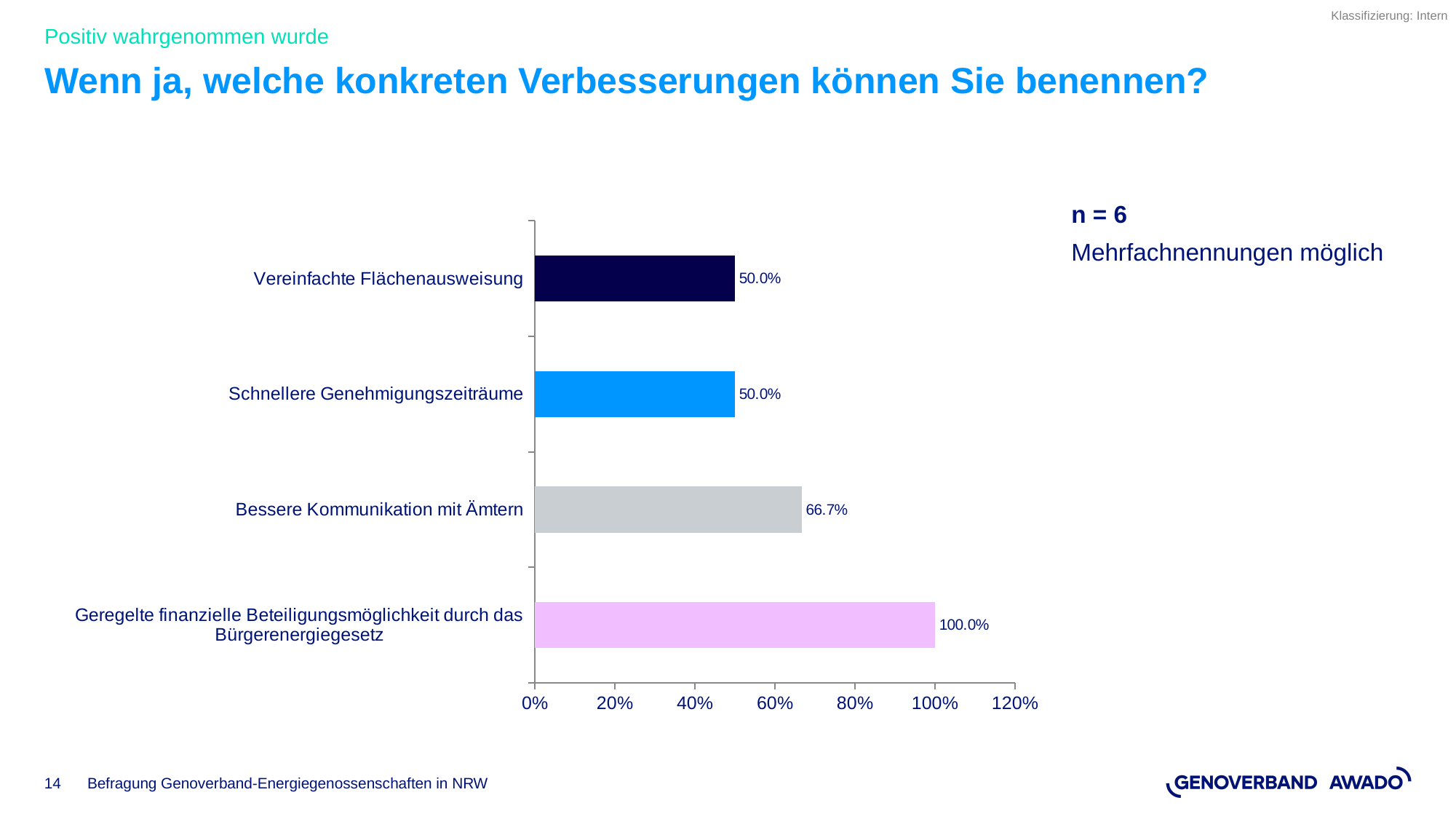
Is the value for Bessere Kommunikation mit Ämtern greater or less than 60%? greater Which is larger, the value for Bessere Kommunikation mit Ämtern or the value for Schnellere Genehmigungszeiträume? Bessere Kommunikation mit Ämtern What is the difference between the values for Geregelte finanzielle Beteiligungsmöglichkeit durch das Bürgerenergiegesetz and Bessere Kommunikation mit Ämtern? 33.3% What is the value for Geregelte finanzielle Beteiligungsmöglichkeit durch das Bürgerenergiegesetz? 100.0% Which category has the highest value? Geregelte finanzielle Beteiligungsmöglichkeit durch das Bürgerenergiegesetz What is the value for Bessere Kommunikation mit Ämtern? 66.7% What kind of chart is shown on the slide? bar chart How many categories are shown in the chart? 4 What is the sample size (n) stated next to the chart? n = 6 What is the highest tick value shown on the x axis? 120% What is the value for Vereinfachte Flächenausweisung? 50.0% What is the difference between the values for Bessere Kommunikation mit Ämtern and Schnellere Genehmigungszeiträume? 16.7%